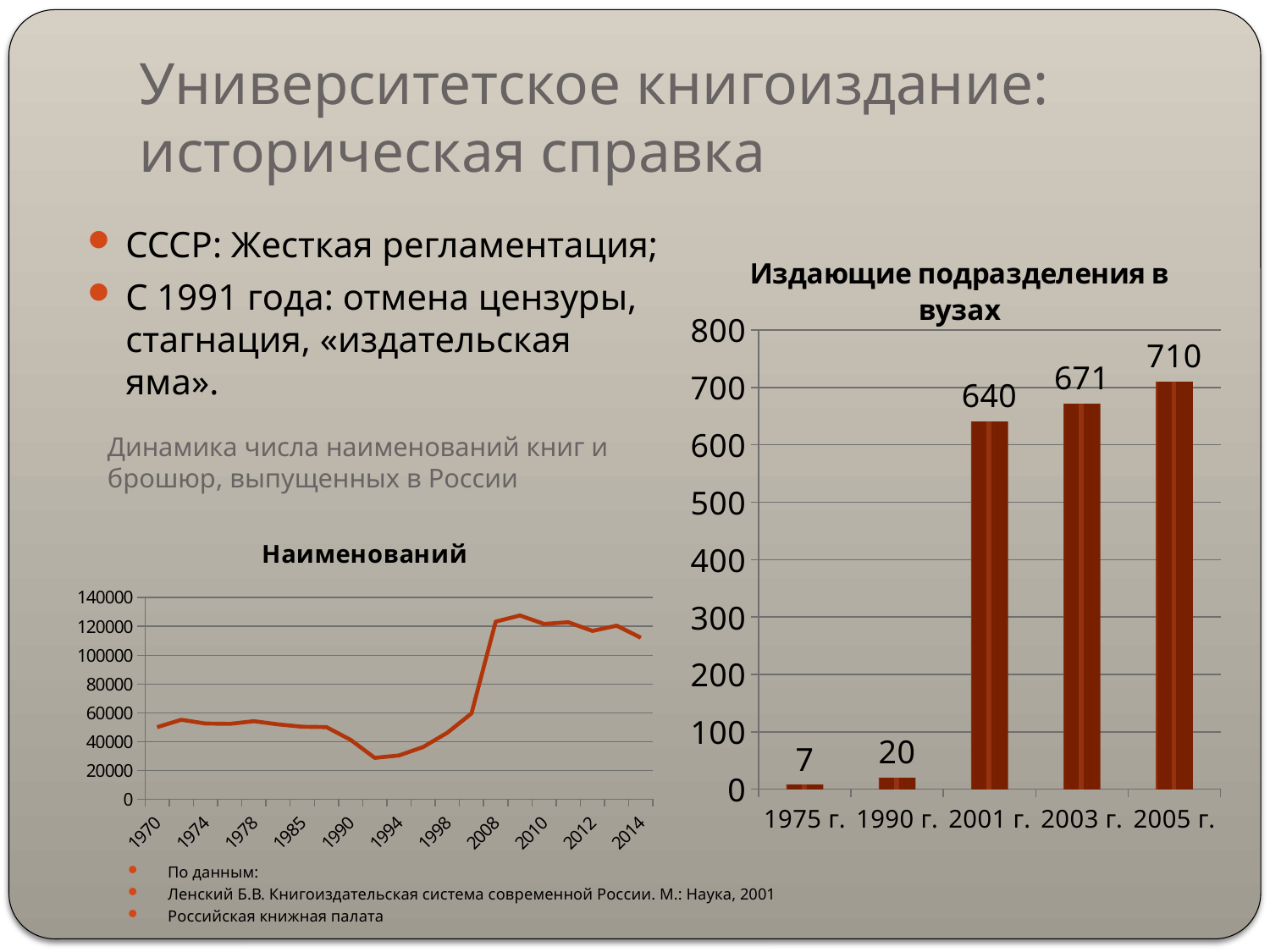
How many categories are shown in the chart titled 'Издающие подразделения в вузах'? 5 In the chart titled 'Издающие подразделения в вузах', what is the value for 1975 г.? 7 In the chart titled 'Издающие подразделения в вузах', which is larger, the value for 2003 г. or the value for 2001 г.? 2003 г. What kind of chart is the chart titled 'Наименований'? line chart In the chart titled 'Издающие подразделения в вузах', which year has the highest value? 2005 г. What kind of chart is the chart titled 'Издающие подразделения в вузах'? bar chart In the chart titled 'Наименований', is the value for 1994 greater or less than 40000? less In the chart titled 'Издающие подразделения в вузах', what is the value for 2005 г.? 710 In the chart titled 'Издающие подразделения в вузах', which year has the lowest value? 1975 г. In the chart titled 'Издающие подразделения в вузах', what is the value for 1990 г.? 20 In the chart titled 'Издающие подразделения в вузах', what is the difference between the values for 2005 г. and 2001 г.? 70 In the chart titled 'Наименований', is the value for 2008 greater or less than 100000? greater